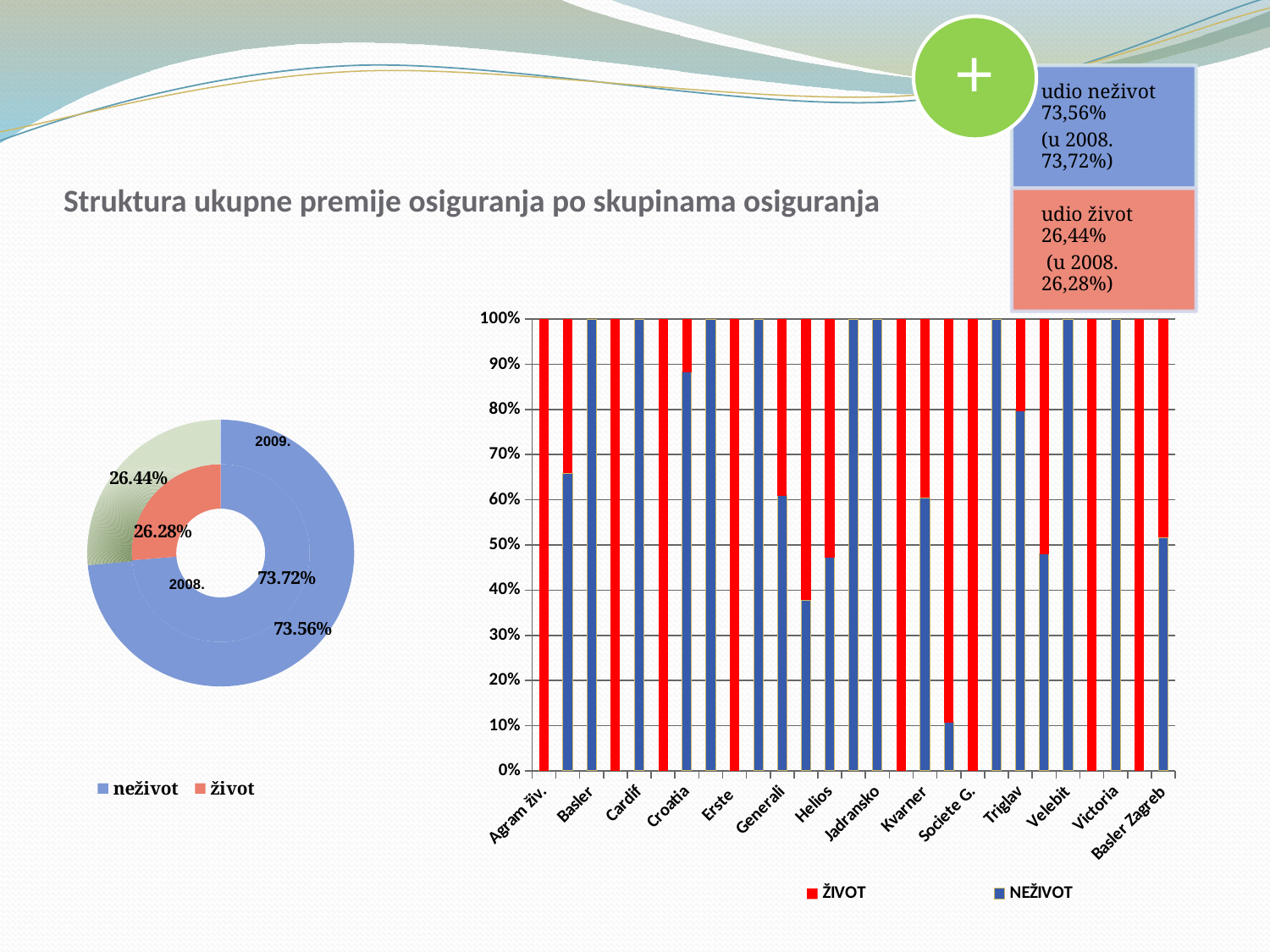
What kind of chart is the chart on the right side of the slide? Stacked bar chart In the doughnut chart, what is the share of neživot in 2008? 73.72% In the bar chart on the right, how many series does the legend list? 2 In the doughnut chart, which category has the larger share in 2009, neživot or život? neživot In the doughnut chart, how many categories does the legend list? 2 In the doughnut chart, by how many percentage points did the život share change from 2008 to 2009? 0.16 In the bar chart on the right, what is the maximum value shown on the vertical axis? 100% In the doughnut chart, what is the share of neživot in 2009? 73.56% In the bar chart on the right, what are the two series named in the legend? ŽIVOT and NEŽIVOT In the doughnut chart, what is the share of život in 2008? 26.28% In the doughnut chart, which colour represents život? Red/salmon In the doughnut chart, what is the share of život in 2009? 26.44%